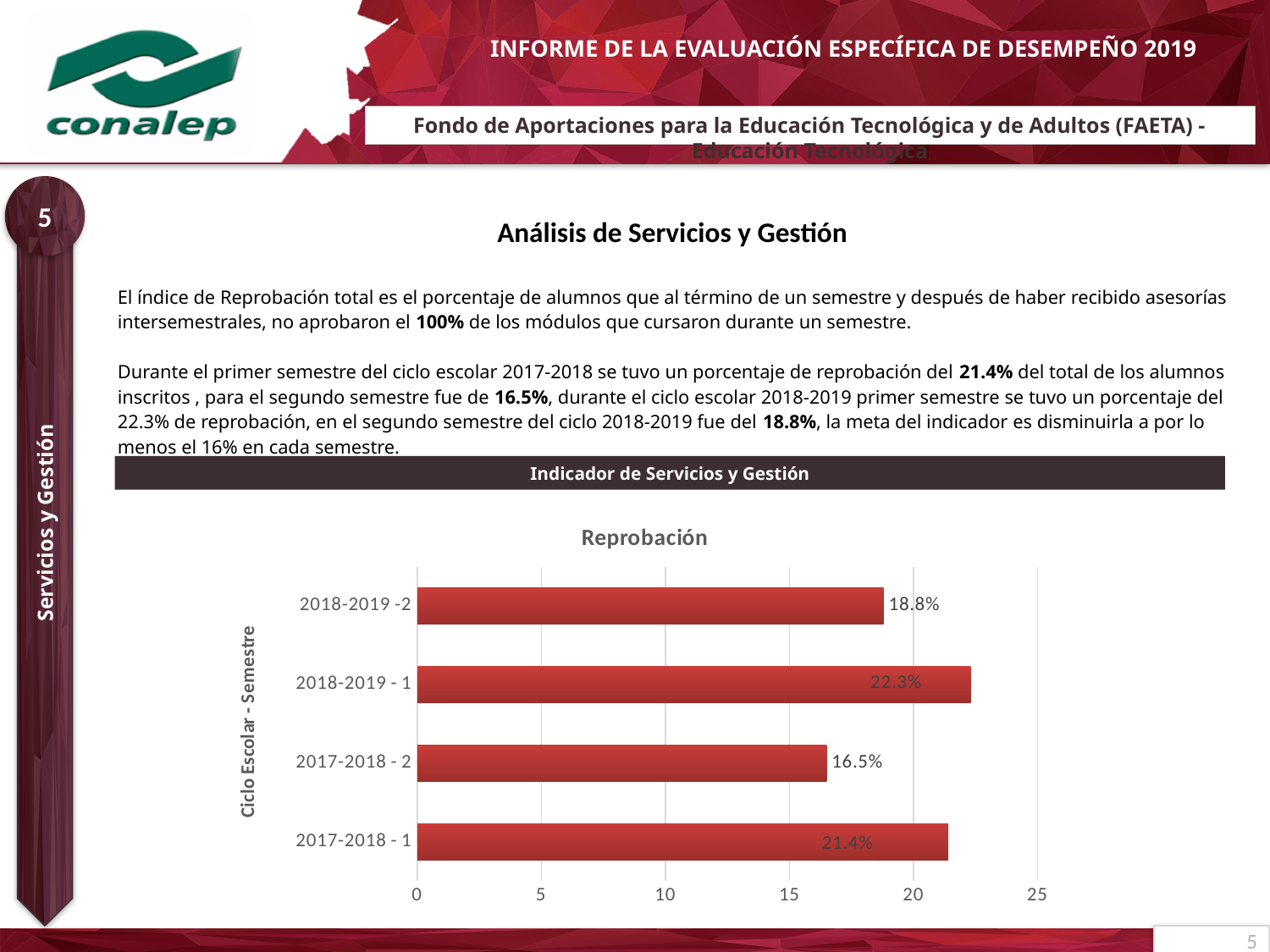
What is the value for 2018-2019 - 1 in the Reprobación chart? 22.3% What is the title of the vertical axis in the Reprobación chart? Ciclo Escolar - Semestre What is the value for 2017-2018 - 1 in the Reprobación chart? 21.4% What is the value for 2017-2018 - 2 in the Reprobación chart? 16.5% What is the value for 2018-2019 -2 in the Reprobación chart? 18.8% Which is larger, the value for 2017-2018 - 1 or the value for 2018-2019 -2? 2017-2018 - 1 Which category has the lowest value in the Reprobación chart? 2017-2018 - 2 What kind of chart is the Reprobación chart? bar chart Is the value for 2018-2019 - 1 greater or less than 20? greater Which category has the highest value in the Reprobación chart? 2018-2019 - 1 How many categories are shown in the Reprobación chart? 4 What is the difference between the values for 2018-2019 - 1 and 2017-2018 - 2? 5.8%